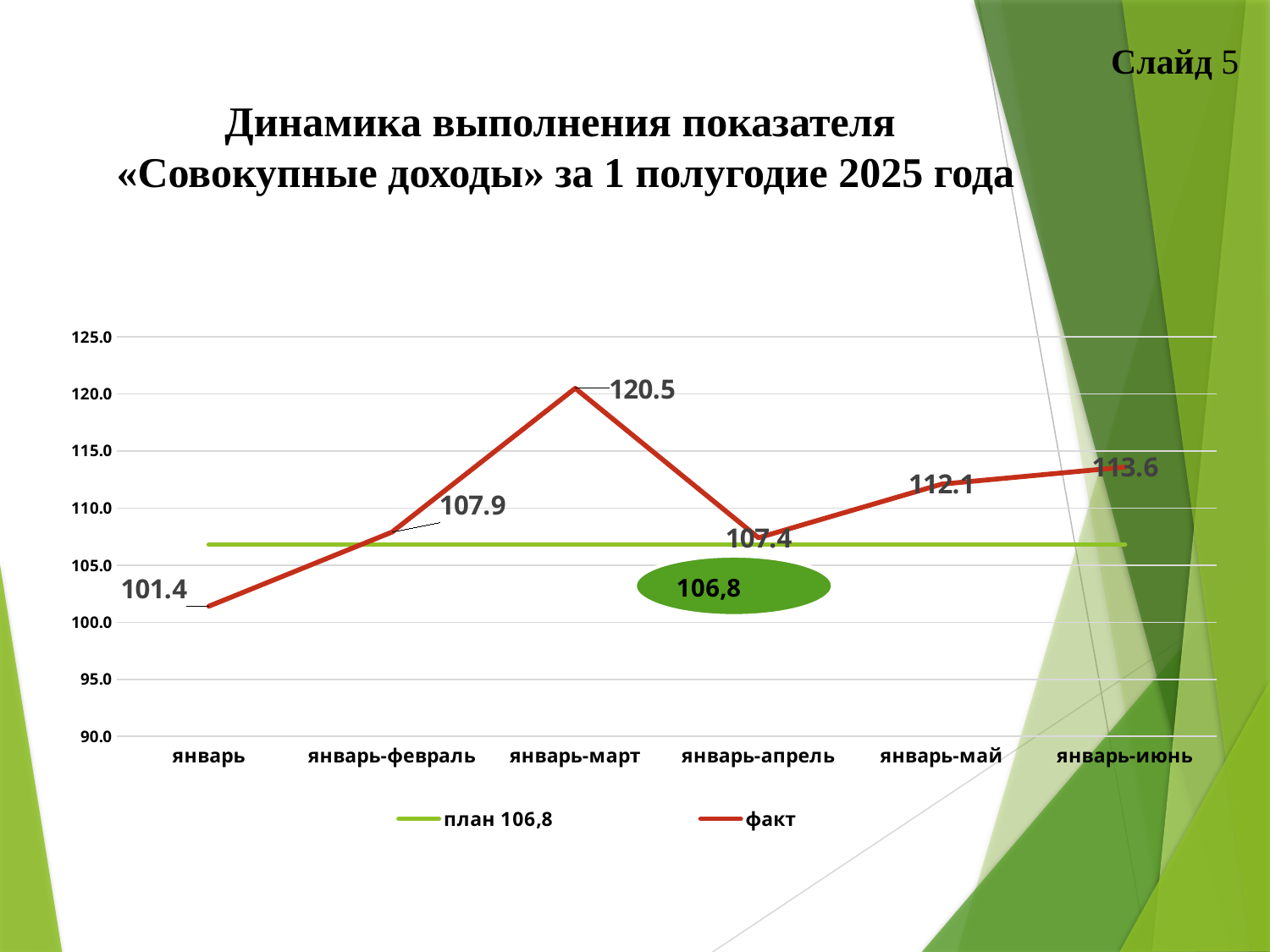
How many categories are shown on the x axis? 6 Is the факт value for январь greater or less than 105.0? less What is the факт value for январь-июнь? 113.6 Which category has the highest факт value? январь-март What kind of chart is shown on the slide? line chart How many series does the legend list? 2 What is the факт value for январь-май? 112.1 Which category has the lowest факт value? январь Which is larger, the факт value for январь-февраль or for январь-май? январь-май What is the факт value for январь? 101.4 What is the факт value for январь-март? 120.5 What is the difference between the факт values for январь-март and январь-апрель? 13.1